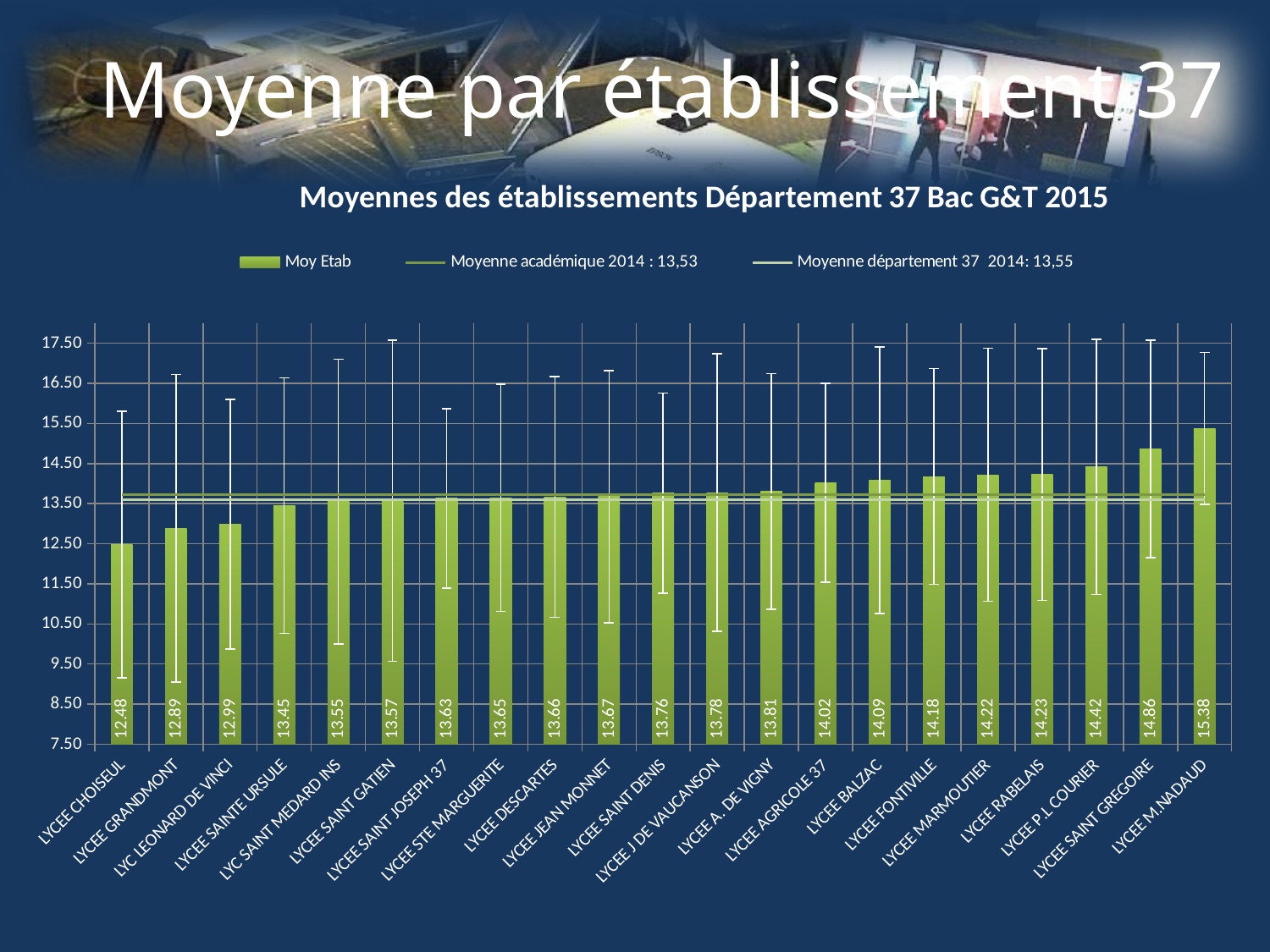
What is the title of the chart? Moyennes des établissements Département 37 Bac G&T 2015 Which establishment has the highest value? LYCEE M.NADAUD Do the bar values rise or fall from left to right along the x axis? Rise What kind of chart is this? Bar chart Which establishment has the lowest value? LYCEE CHOISEUL How many establishments are shown on the x axis? 21 How many series does the legend list? 3 What is the value for LYCEE BALZAC? 14.09 Which has a larger value, LYCEE GRANDMONT or LYCEE RABELAIS? LYCEE RABELAIS What is the value for LYCEE CHOISEUL? 12.48 What is the value for LYCEE SAINT GREGOIRE? 14.86 What is the difference between the values for LYCEE M.NADAUD and LYCEE CHOISEUL? 2.90